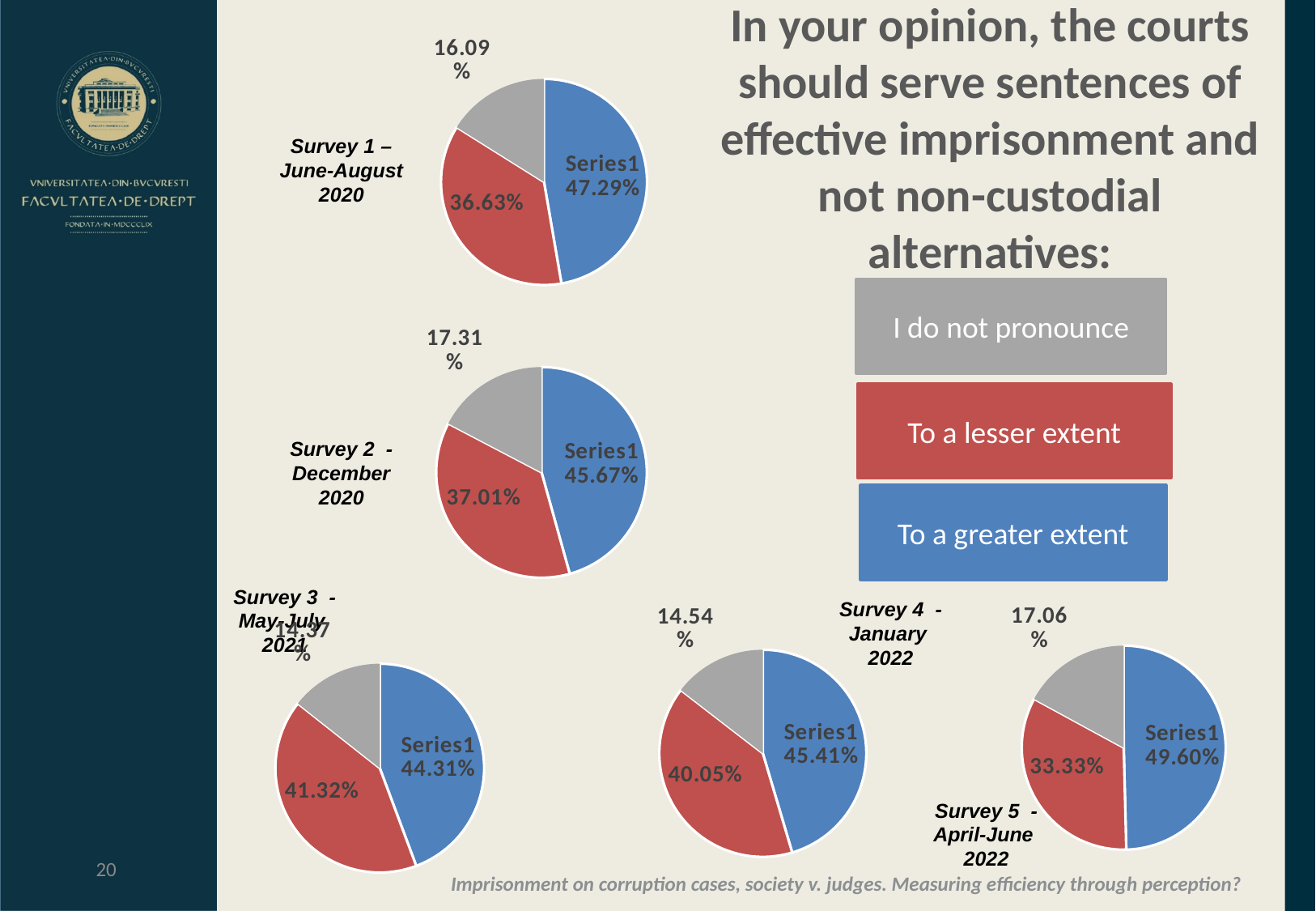
In the Survey 1 – June-August 2020 pie chart, which response has the largest slice? To a greater extent In the Survey 4 - January 2022 pie chart, what share answered "To a lesser extent"? 40.05% In the Survey 3 - May-July 2021 pie chart, what is the value of the "I do not pronounce" slice? 14.37% What type of chart is used to show the survey results on this slide? Pie chart In the Survey 3 - May-July 2021 pie chart, what is the difference between the "To a greater extent" and "To a lesser extent" shares? 2.99% In the Survey 4 - January 2022 pie chart, which is larger: "To a greater extent" or "I do not pronounce"? To a greater extent Which colour represents the "To a lesser extent" response in the pie charts? Red In the Survey 5 - April-June 2022 pie chart, which response has the smallest slice? I do not pronounce In the Survey 1 – June-August 2020 pie chart, what share of respondents answered "To a greater extent"? 47.29% In the Survey 5 - April-June 2022 pie chart, what share answered "To a greater extent"? 49.60% How many pie charts are shown on the slide? 5 In the Survey 2 - December 2020 pie chart, what is the value of the "To a lesser extent" slice? 37.01%